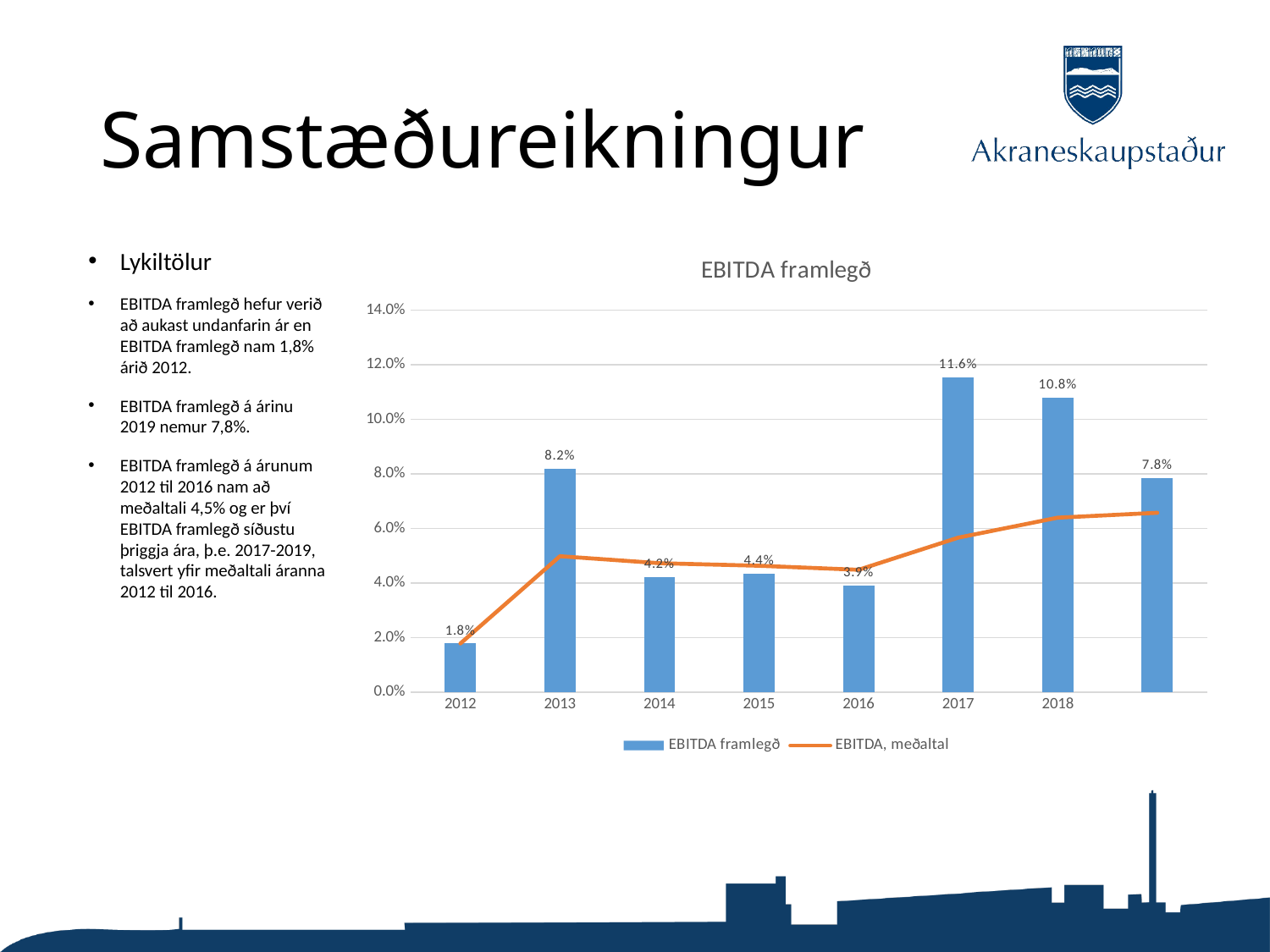
What is the EBITDA framlegð value for 2018? 10.8% Is the EBITDA, meðaltal line value at 2018 greater or less than 8.0%? less How many bars are plotted in the chart? 8 What is the difference between the EBITDA framlegð values for 2017 and 2018? 0.8% What is the EBITDA framlegð value for 2016? 3.9% What is the title of the chart? EBITDA framlegð What is the EBITDA framlegð value for 2013? 8.2% What is the value shown on the rightmost bar of the chart? 7.8% How many series does the legend list? 2 Which year has the lowest EBITDA framlegð bar? 2012 Which is larger, the EBITDA framlegð bar for 2014 or for 2015? 2015 Which year has the highest EBITDA framlegð bar? 2017